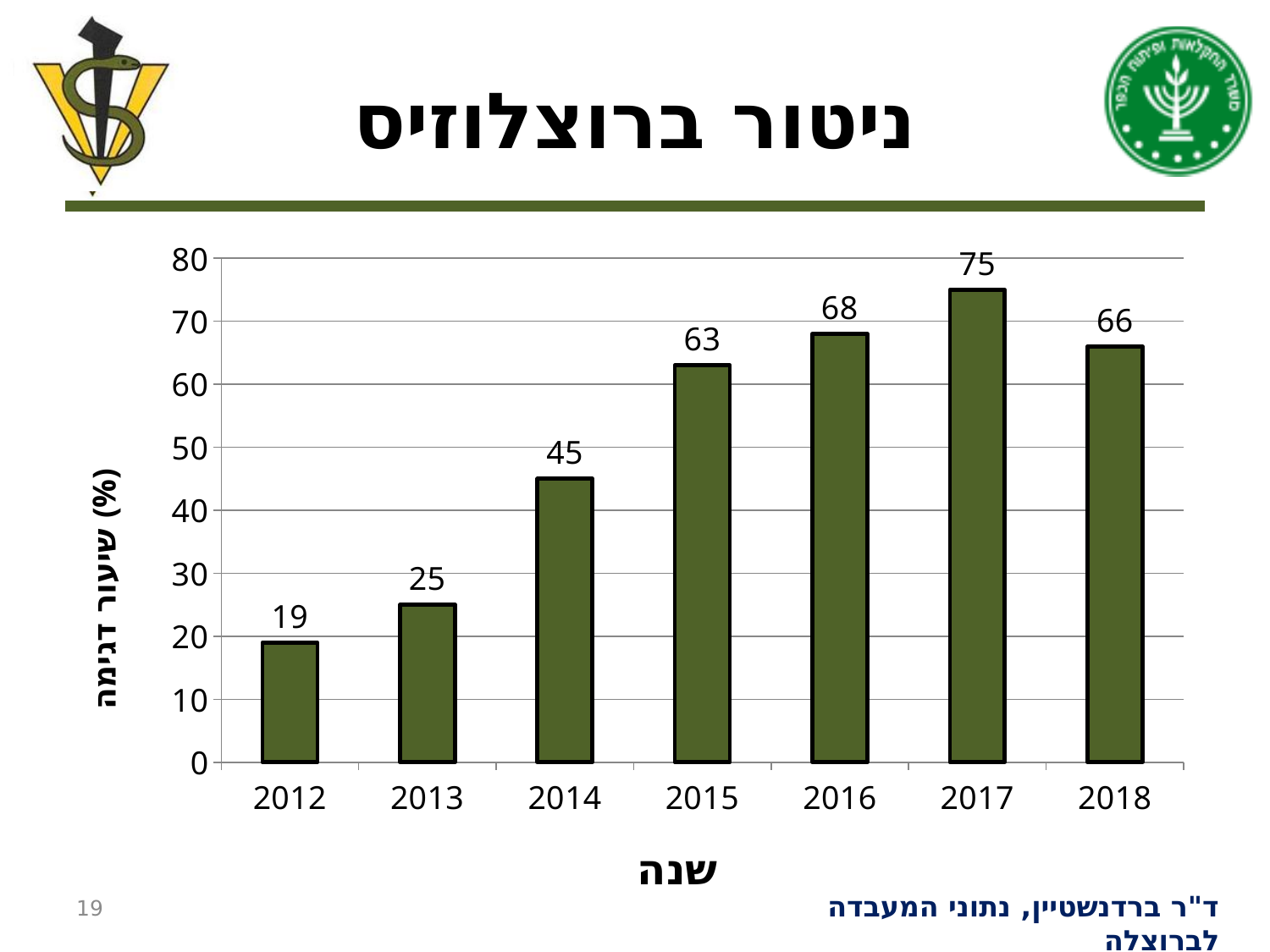
Which year has the lowest value? 2012 Which year has the highest value? 2017 Do the values rise or fall from 2012 to 2017? Rise What is the difference between the values for 2017 and 2012? 56 What is the difference between the values for 2014 and 2013? 20 What is the value for 2018? 66 What kind of chart is shown on the slide? Bar chart What is the value for 2012? 19 How many years are shown on the x axis? 7 What is the value for 2015? 63 Which is larger, the value for 2016 or the value for 2018? 2016 What is the x-axis title of the chart? שנה